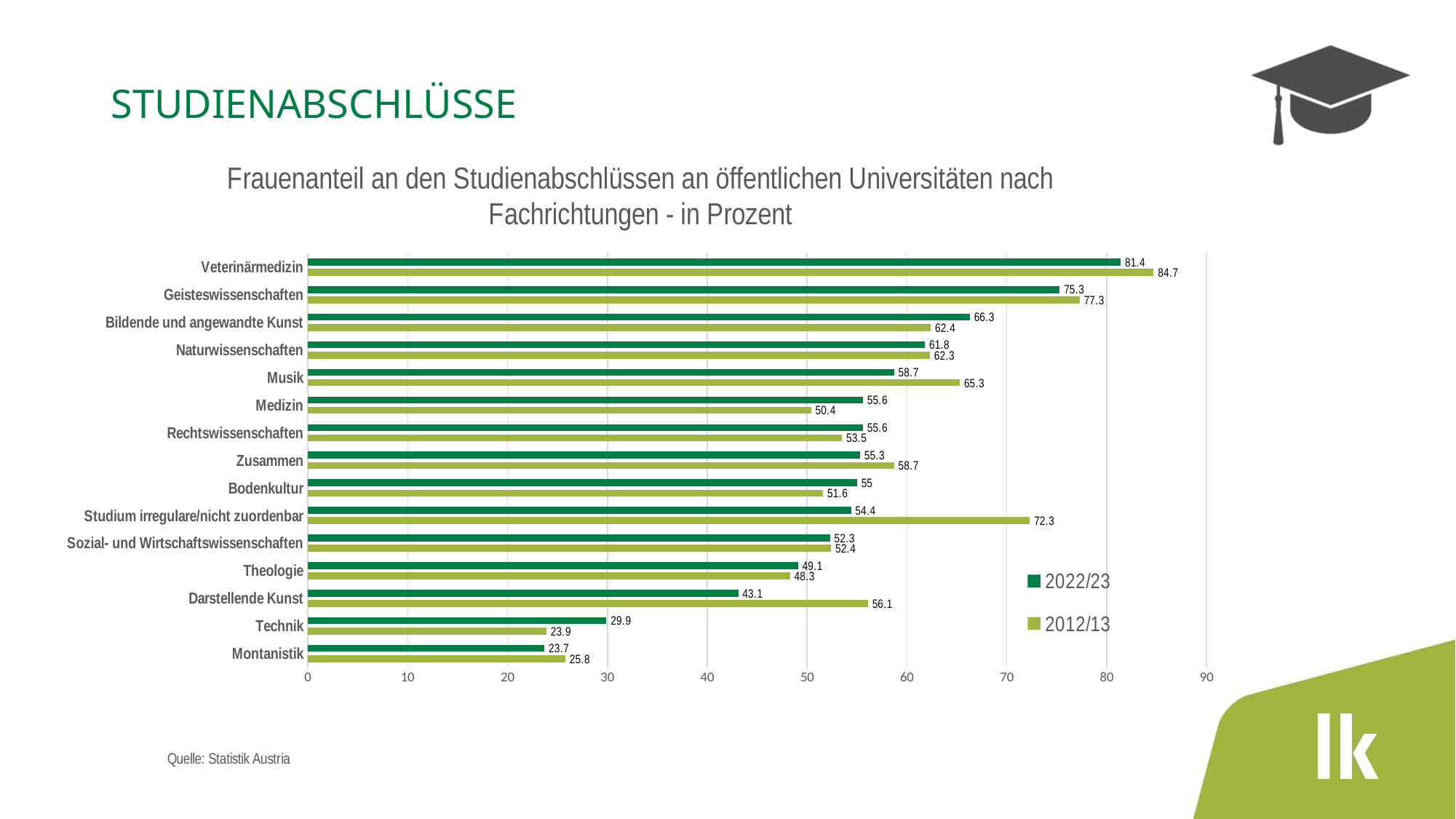
What is the value for Studium irregulare/nicht zuordenbar in the 2012/13 series? 72.3 What is the value for Technik in the 2012/13 series? 23.9 What is the difference between the 2012/13 and 2022/23 values for Darstellende Kunst? 13 How many series does the legend list? 2 How many categories are shown on the chart? 15 What kind of chart is shown on the slide? Bar chart Which category has the highest value in the 2022/23 series? Veterinärmedizin Which category has the lowest value in the 2022/23 series? Montanistik What is the value for Veterinärmedizin in the 2022/23 series? 81.4 What is the difference between the 2022/23 and 2012/13 values for Technik? 6 Which category has the lowest value in the 2012/13 series? Technik For Musik, which series has the larger value, 2022/23 or 2012/13? 2012/13